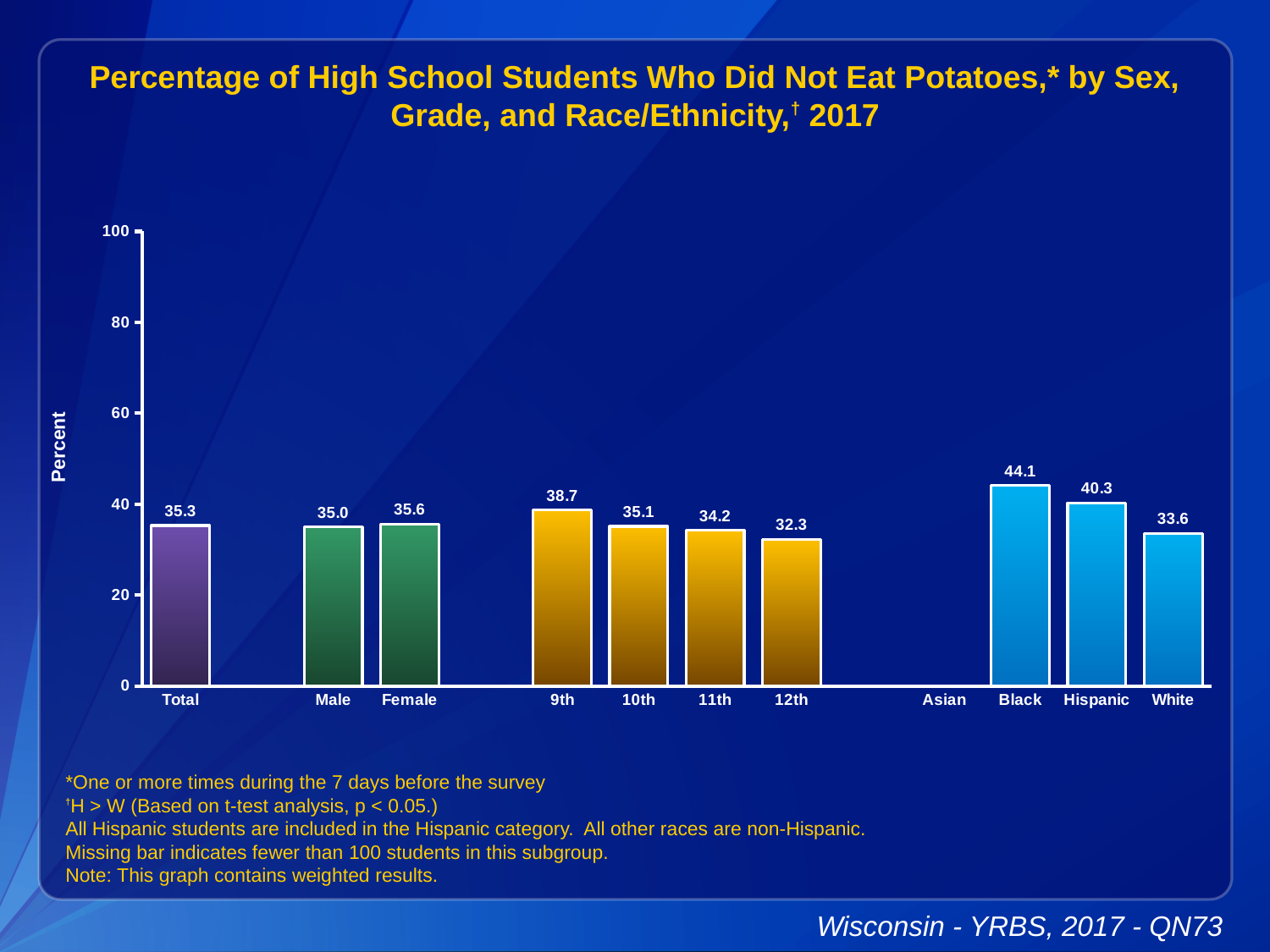
What kind of chart is shown? bar chart Is the value for Hispanic greater or less than 40? greater What is the difference between the Black and White values? 10.5 What is the value for Total? 35.3 Which is larger, the value for 9th grade or the value for 10th grade? 9th What is the value for Black students? 44.1 What is the value for 12th grade? 32.3 How many bars are plotted on the chart? 10 Which category has no bar shown? Asian What is the difference between the Female and Male values? 0.6 Which grade has the lowest value? 12th Which category has the highest value? Black